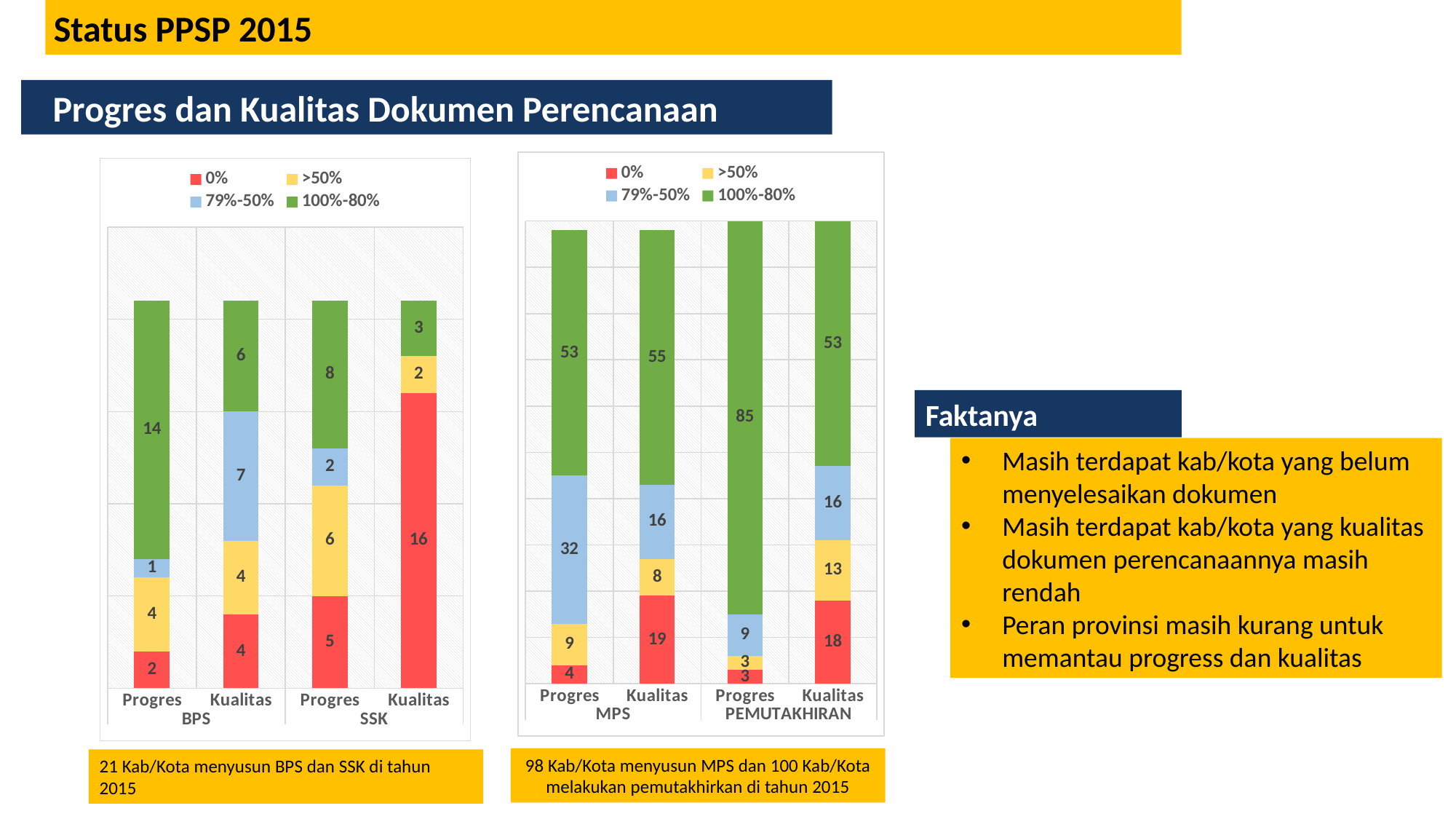
What kind of chart is the right chart (MPS and PEMUTAKHIRAN)? Stacked bar chart In the right chart (MPS and PEMUTAKHIRAN), which colour represents the 0% series? Red How many series does the legend of the left chart (BPS and SSK) list? 4 In the left chart (BPS and SSK), what is the value of the 0% segment for SSK Kualitas? 16 In the left chart (BPS and SSK), what is the value of the 100%-80% segment for BPS Progres? 14 In the right chart (MPS and PEMUTAKHIRAN), which is larger: the >50% segment for PEMUTAKHIRAN Kualitas or for MPS Kualitas? PEMUTAKHIRAN Kualitas In the right chart (MPS and PEMUTAKHIRAN), what is the total of the stacked bar for MPS Kualitas? 98 In the left chart (BPS and SSK), what is the total of the stacked bar for SSK Progres? 21 In the left chart (BPS and SSK), which bar has the largest 0% segment? SSK Kualitas In the right chart (MPS and PEMUTAKHIRAN), what is the value of the 79%-50% segment for MPS Progres? 32 In the right chart (MPS and PEMUTAKHIRAN), what is the value of the 100%-80% segment for PEMUTAKHIRAN Progres? 85 In the right chart (MPS and PEMUTAKHIRAN), what is the difference between the 0% values for MPS Kualitas and MPS Progres? 15